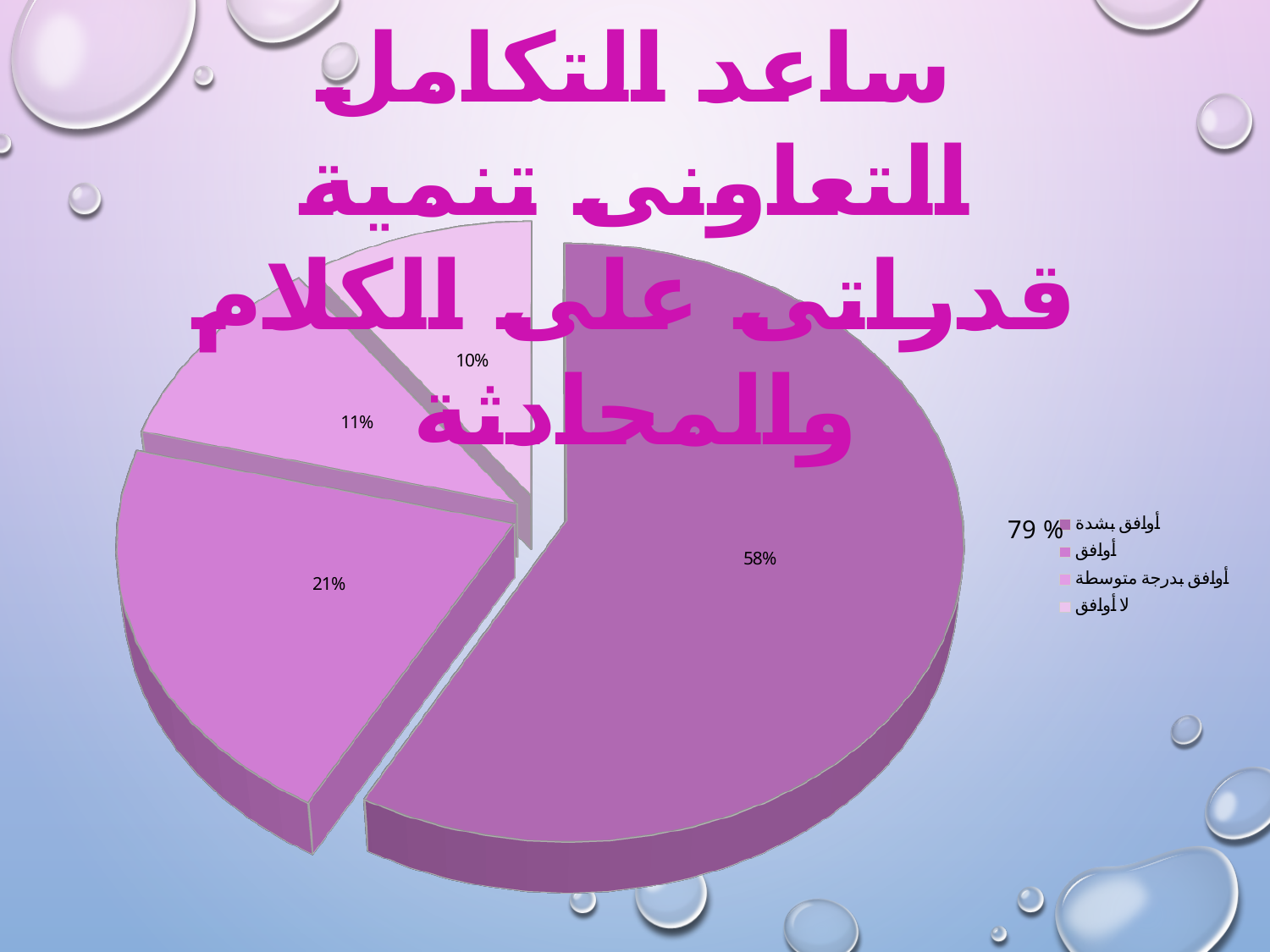
What percentage is shown for the slice labelled أوافق (the second legend entry)? 21% What is the difference in percentage points between the 58% slice and the 21% slice? 37 What percentage is shown for the slice labelled لا أوافق? 10% How many slices does the pie chart have? 4 What percentage is shown for the largest slice of the pie chart? 58% What kind of chart is shown on the slide? pie chart How many entries does the legend of the pie chart list? 4 Which legend category has the largest slice of the pie chart? أوافق بشدة What percentage is shown for the slice labelled أوافق بدرجة متوسطة? 11% Which slice is larger, the one for أوافق or the one for أوافق بدرجة متوسطة? أوافق What share of the pie does the أوافق بشدة slice represent? 58% Which legend category has the smallest slice of the pie chart? لا أوافق